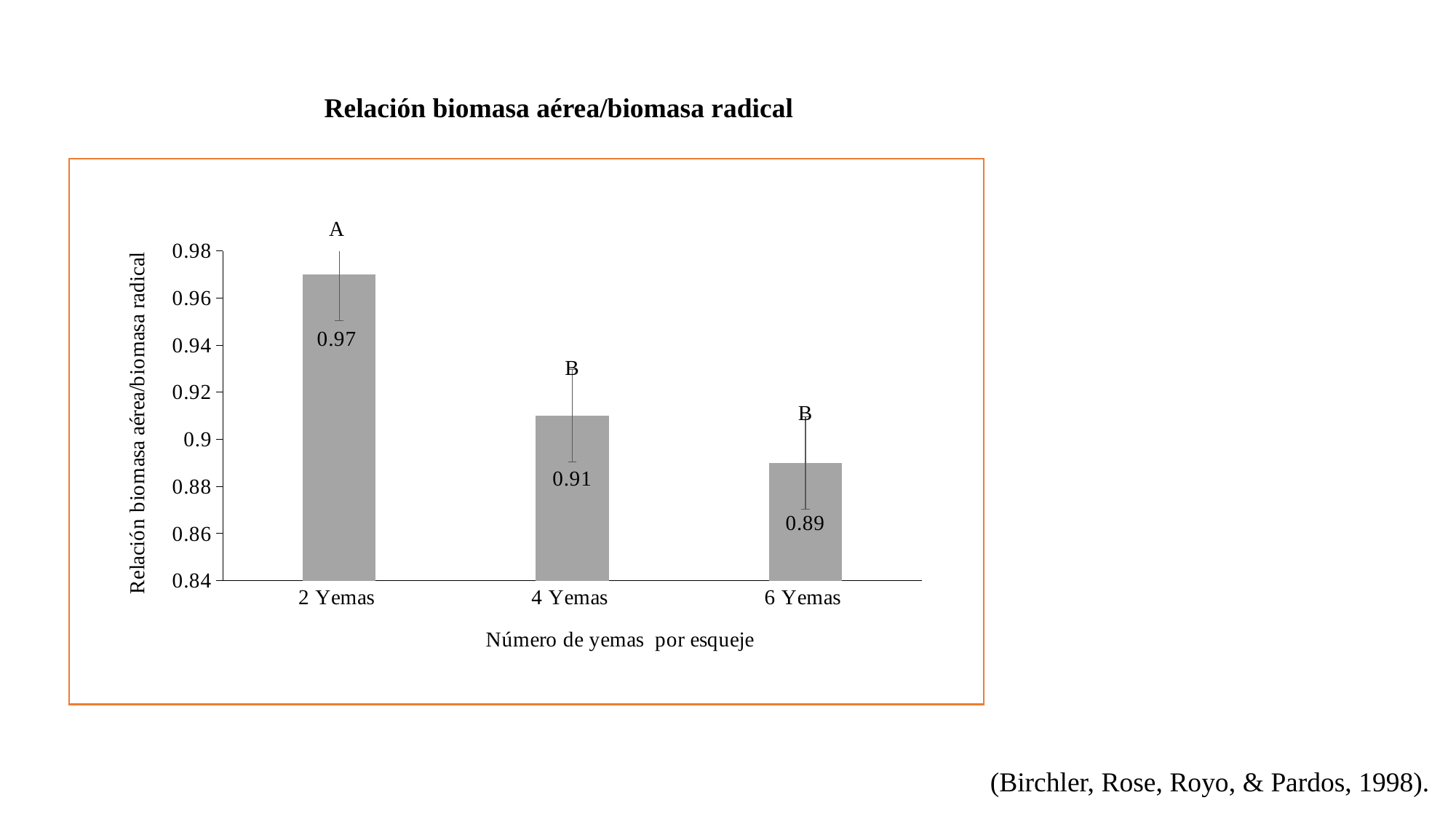
What kind of chart is shown on the slide? bar chart Which is larger, the value for 2 Yemas or the value for 4 Yemas? 2 Yemas How many categories are shown on the x axis? 3 What is the value for 4 Yemas? 0.91 What is the value for 6 Yemas? 0.89 Is the value for 4 Yemas greater or less than 0.9? greater Do the values rise or fall as the number of yemas increases along the x axis? fall What is the difference between the values for 4 Yemas and 6 Yemas? 0.02 Which category has the highest value? 2 Yemas What is the value for 2 Yemas? 0.97 Which category has the lowest value? 6 Yemas What is the difference between the values for 2 Yemas and 6 Yemas? 0.08